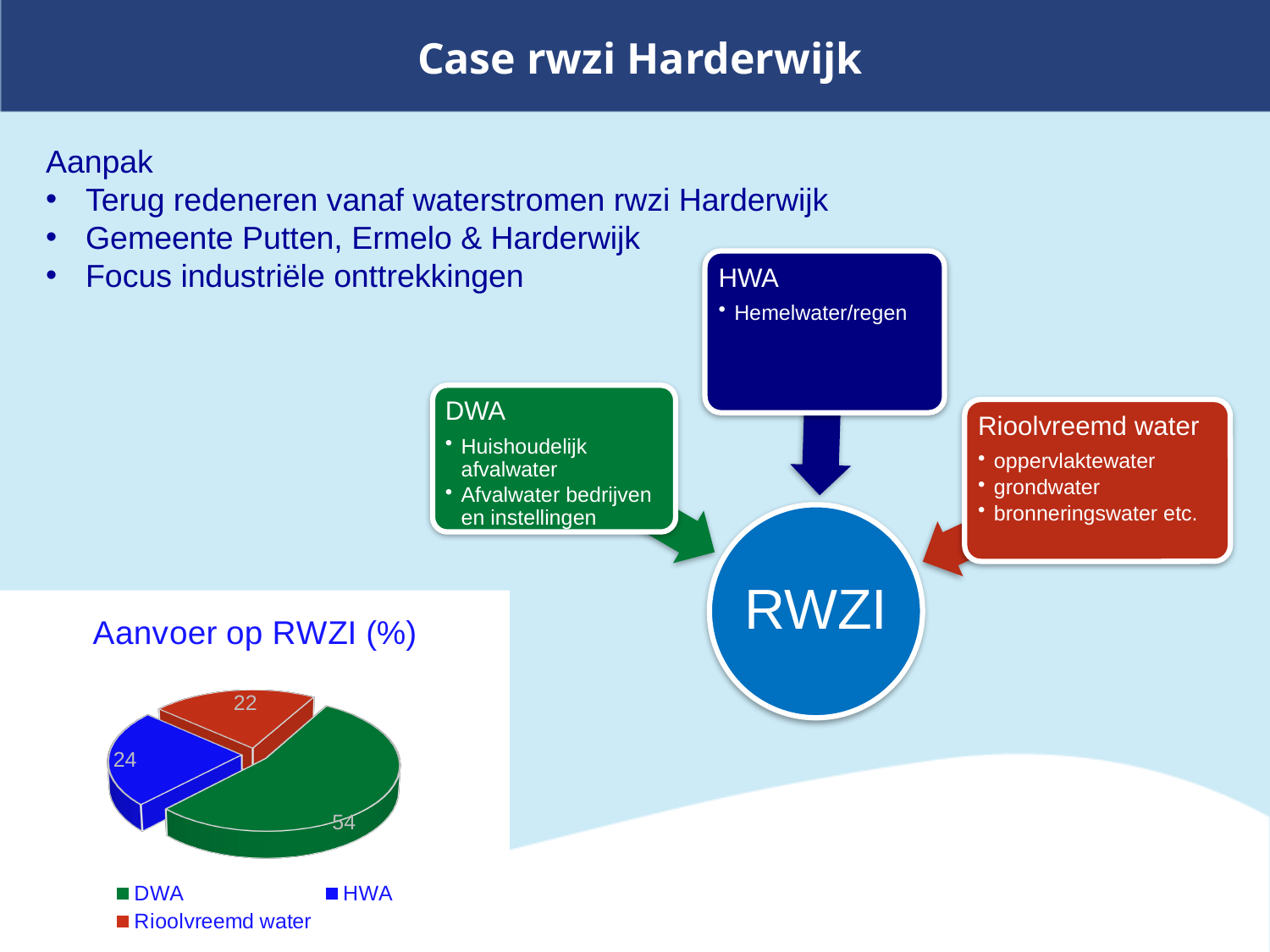
Which category has the largest slice in the pie chart? DWA How many slices does the pie chart have? 3 In the pie chart, what is the value for HWA? 24 What kind of chart is shown at the bottom left of the slide? pie chart What colour is the DWA slice in the pie chart? green In the pie chart, which is larger, HWA or Rioolvreemd water? HWA How many entries does the legend of the pie chart list? 3 In the pie chart, what is the value for DWA? 54 Which category has the smallest slice in the pie chart? Rioolvreemd water What is the difference between the DWA and HWA values in the pie chart? 30 What is the title of the pie chart on the slide? Aanvoer op RWZI (%) In the pie chart, what is the value for Rioolvreemd water? 22